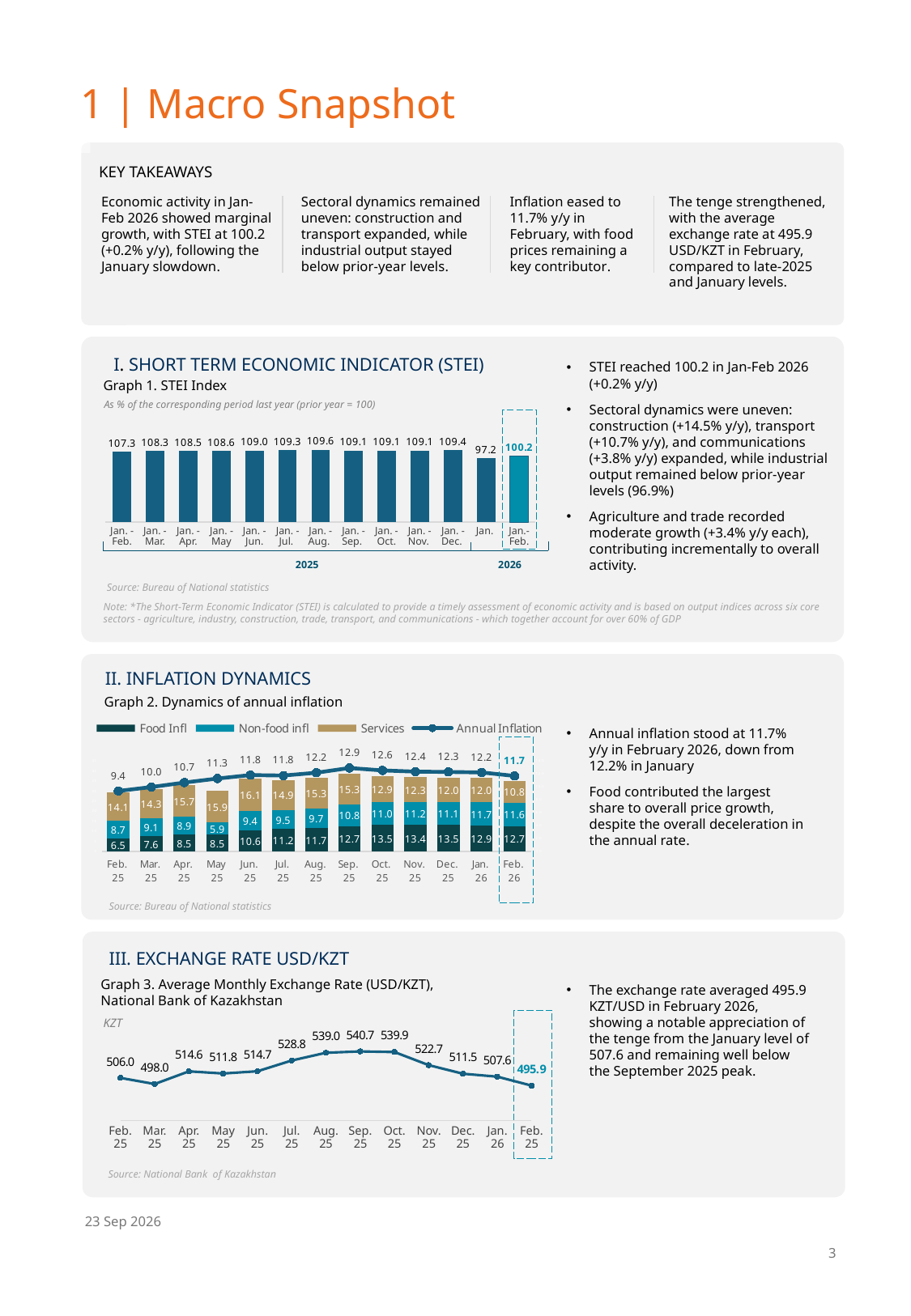
In Graph 2 (Dynamics of annual inflation), in which month does Annual Inflation reach its highest value? Sep. 25 In Graph 3 (Average Monthly Exchange Rate USD/KZT), what is the value for Sep. 25? 540.7 In Graph 2 (Dynamics of annual inflation), what is the Annual Inflation value for Feb. 26? 11.7 In Graph 1 (STEI Index), how many bars are plotted? 13 In Graph 2 (Dynamics of annual inflation), what is the Food Infl value for Feb. 26? 12.7 In Graph 1 (STEI Index), which period has the highest value? Jan.-Aug. 2025 In Graph 1 (STEI Index), what is the difference between the Jan.-Feb. 2026 value and the Jan. 2026 value? 3.0 What kind of chart is Graph 3 (Average Monthly Exchange Rate USD/KZT)? Line chart In Graph 1 (STEI Index), which period has the lowest value? Jan. 2026 In Graph 1 (STEI Index), what is the value for Jan.-Feb. 2026? 100.2 In Graph 3 (Average Monthly Exchange Rate USD/KZT), what is the difference between the Jan. 26 value and the Feb. 26 value? 11.7 In Graph 2 (Dynamics of annual inflation), how many entries does the legend list? 4